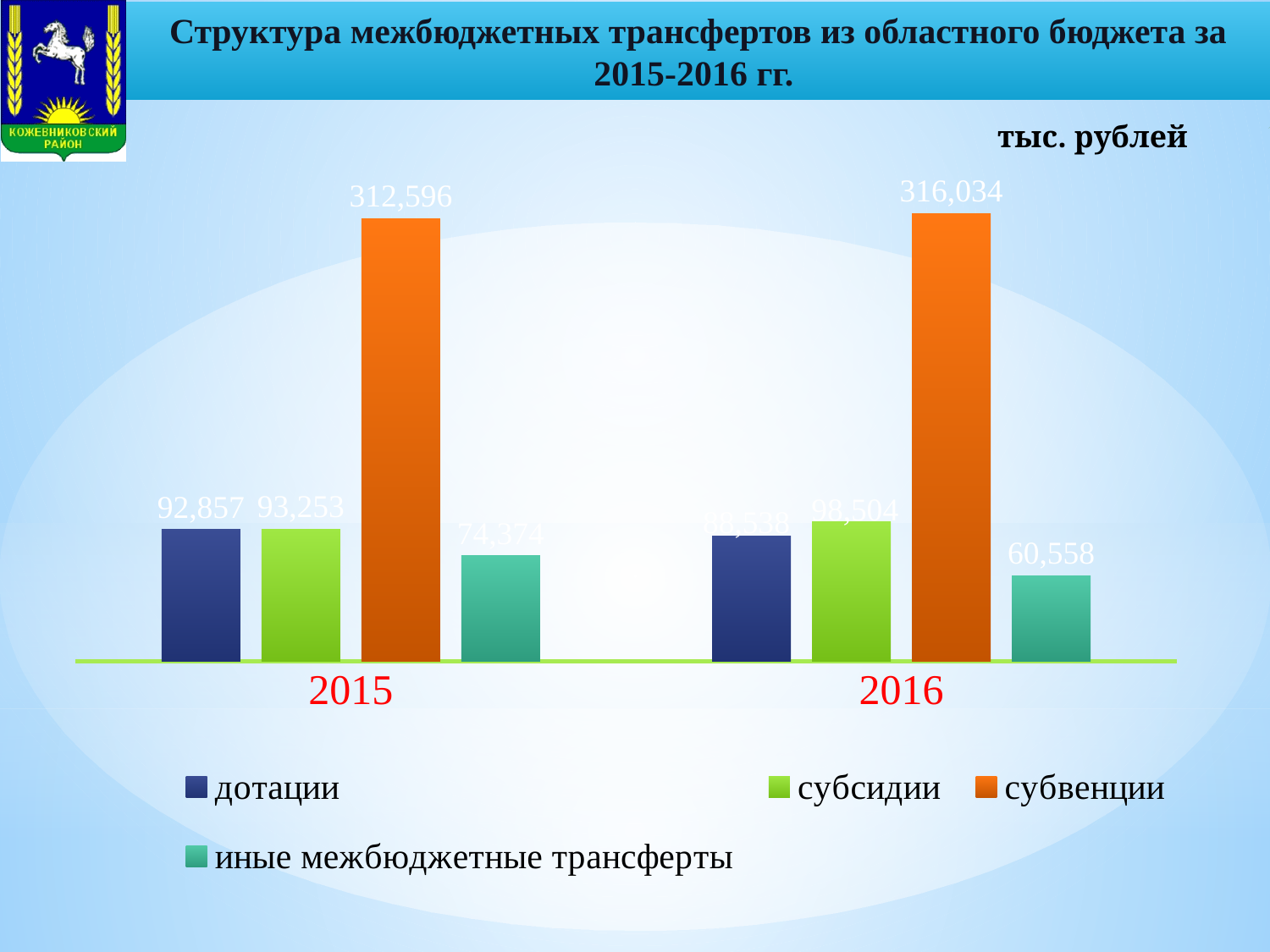
How many series does the legend list? 4 Which is larger: дотации in 2015 or дотации in 2016? дотации in 2015 By how much did субвенции increase from 2015 to 2016? 3,438 What unit is stated for the values on the chart? тыс. рублей What kind of chart is shown on the slide? bar chart Which series has the lowest value in 2016? иные межбюджетные трансферты What is the value for дотации in 2016? 88,538 What is the value for субсидии in 2016? 98,504 What is the value for иные межбюджетные трансферты in 2015? 74,374 What is the difference between иные межбюджетные трансферты in 2015 and in 2016? 13,816 What is the value for субвенции in 2015? 312,596 Which series has the highest value in 2016? субвенции